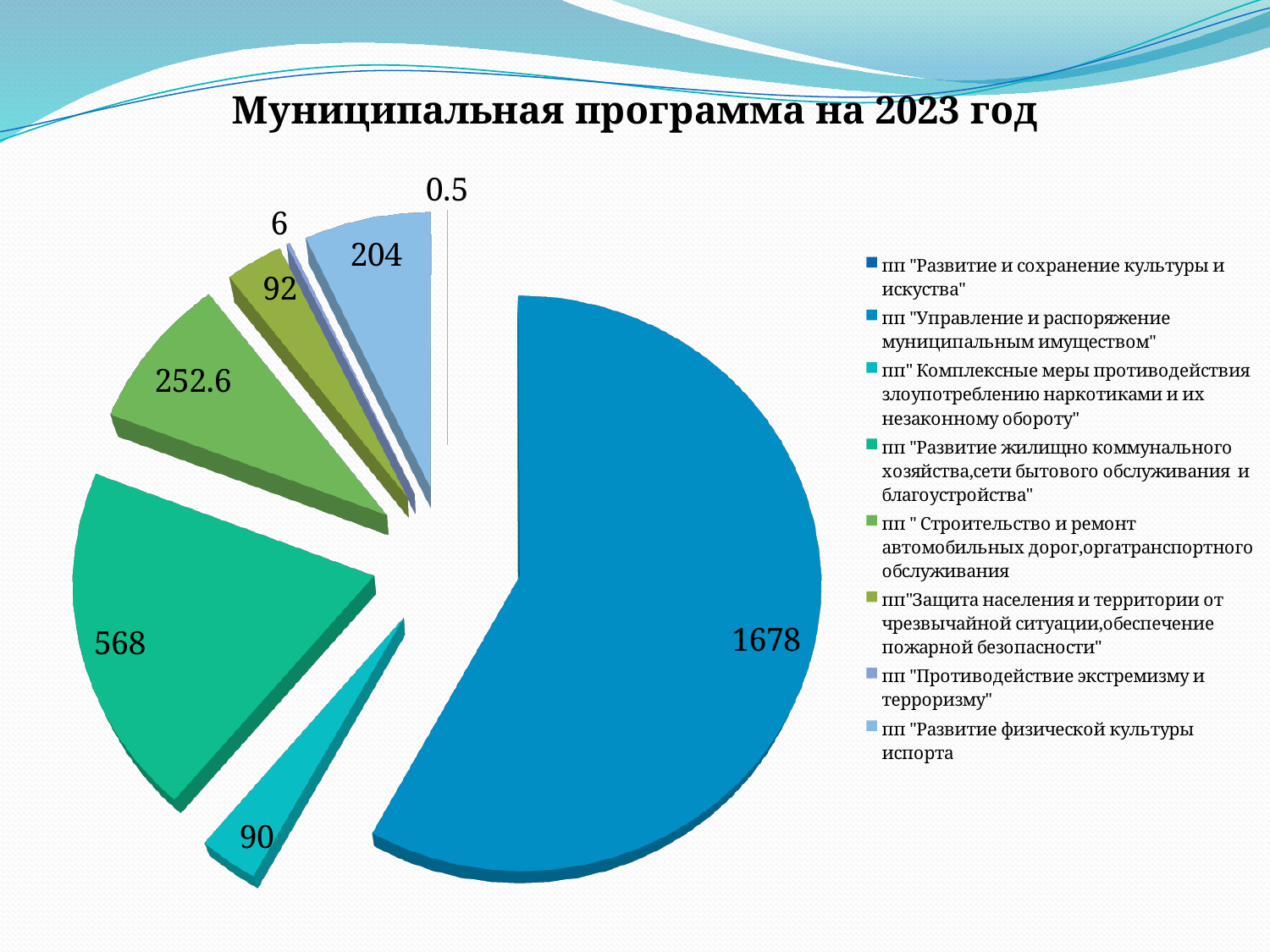
What kind of chart is shown on the slide? pie chart How many entries does the legend list? 8 What is the value for пп "Развитие и сохранение культуры и искуства"? 0.5 What is the value for пп "Развитие физической культуры испорта"? 204 What is the difference between the largest slice (1678) and the slice labelled 568? 1110 How many slices does the pie chart have? 8 What is the value for пп "Развитие жилищно коммунального хозяйства,сети бытового обслуживания и благоустройства"? 568 Which is larger: the slice for пп "Развитие физической культуры испорта" or the slice for пп "Развитие жилищно коммунального хозяйства,сети бытового обслуживания и благоустройства"? пп "Развитие жилищно коммунального хозяйства,сети бытового обслуживания и благоустройства" What is the title of the chart? Муниципальная программа на 2023 год What is the value for пп "Противодействие экстремизму и терроризму"? 6 Which program has the largest slice of the pie? пп "Управление и распоряжение муниципальным имуществом" Which program has the smallest slice of the pie? пп "Развитие и сохранение культуры и искуства"